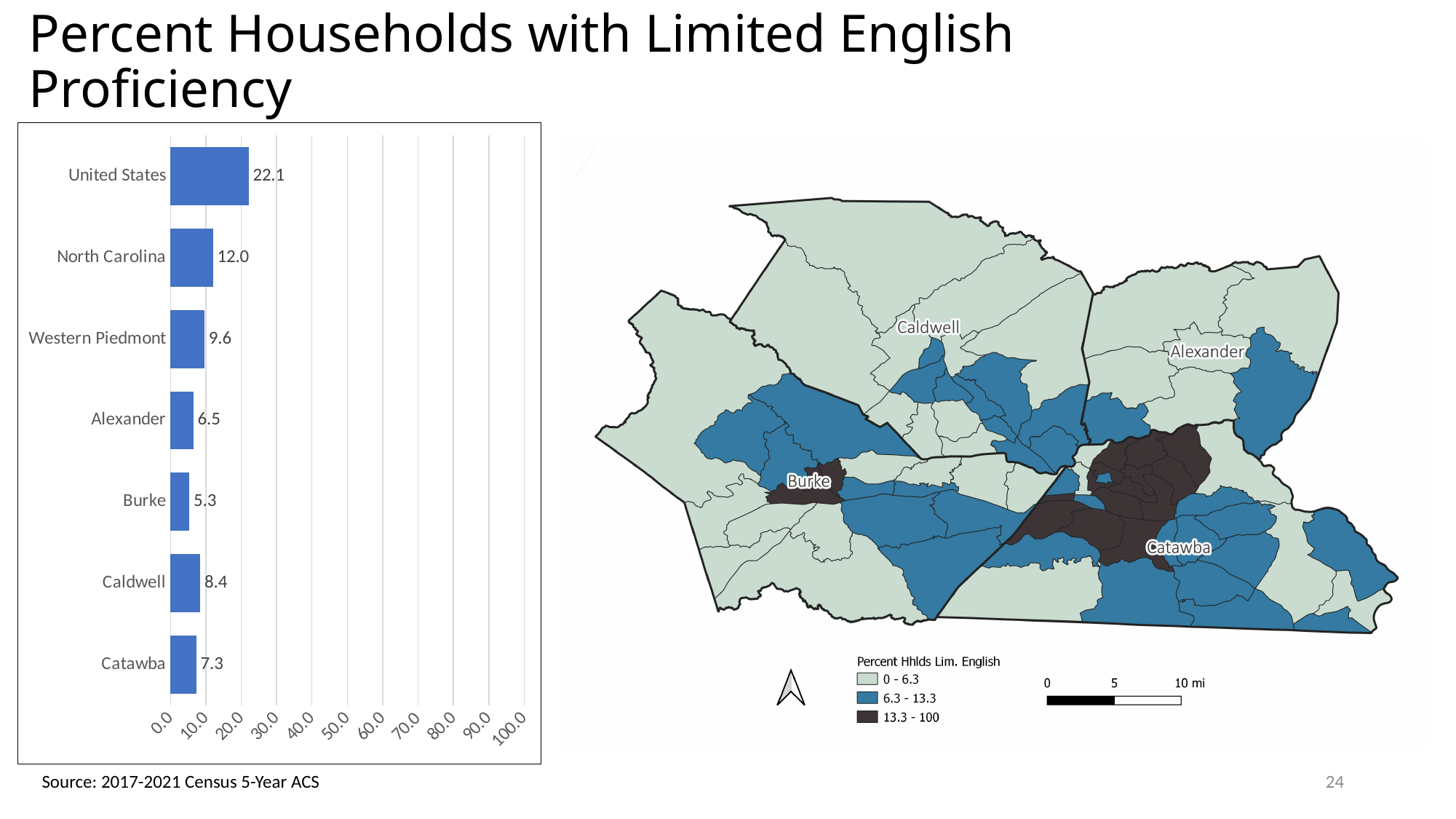
What is the difference between the values for the United States and North Carolina in the bar chart? 10.1 Which has a larger value in the bar chart, Caldwell or Catawba? Caldwell Which category has the lowest value in the bar chart? Burke What is the value for Burke in the bar chart? 5.3 How many categories are shown in the bar chart? 7 What is the title of the slide? Percent Households with Limited English Proficiency What is the value for North Carolina in the bar chart? 12.0 What is the value for Western Piedmont in the bar chart? 9.6 What is the value for the United States in the bar chart? 22.1 Which category has the highest value in the bar chart? United States What kind of chart is shown on the left of the slide? bar chart Is the value for Alexander in the bar chart greater or less than 10.0? less